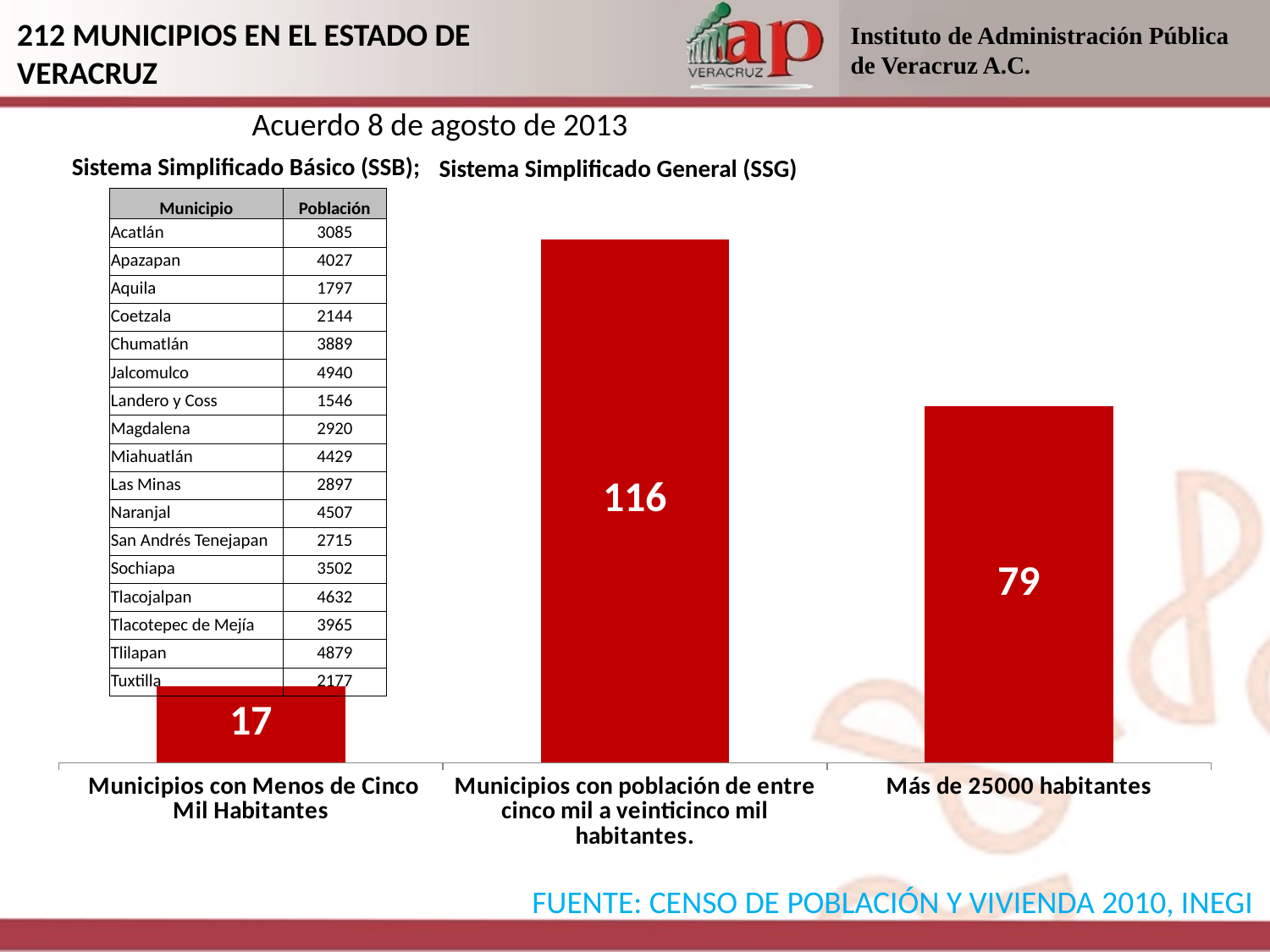
What is the value for 'Más de 25000 habitantes'? 79 How many categories are shown in the bar chart? 3 Which is larger: the value for 'Más de 25000 habitantes' or the value for 'Municipios con Menos de Cinco Mil Habitantes'? Más de 25000 habitantes What colour are the bars in the chart? red What is the difference between the values for 'Más de 25000 habitantes' and 'Municipios con Menos de Cinco Mil Habitantes'? 62 What is the value for 'Municipios con Menos de Cinco Mil Habitantes'? 17 What is the total of the three values shown in the bar chart? 212 What kind of chart is shown on the slide? bar chart What is the value for 'Municipios con población de entre cinco mil a veinticinco mil habitantes.'? 116 What is the difference between the values for 'Municipios con población de entre cinco mil a veinticinco mil habitantes.' and 'Más de 25000 habitantes'? 37 Which category has the lowest value? Municipios con Menos de Cinco Mil Habitantes Which category has the highest value? Municipios con población de entre cinco mil a veinticinco mil habitantes.